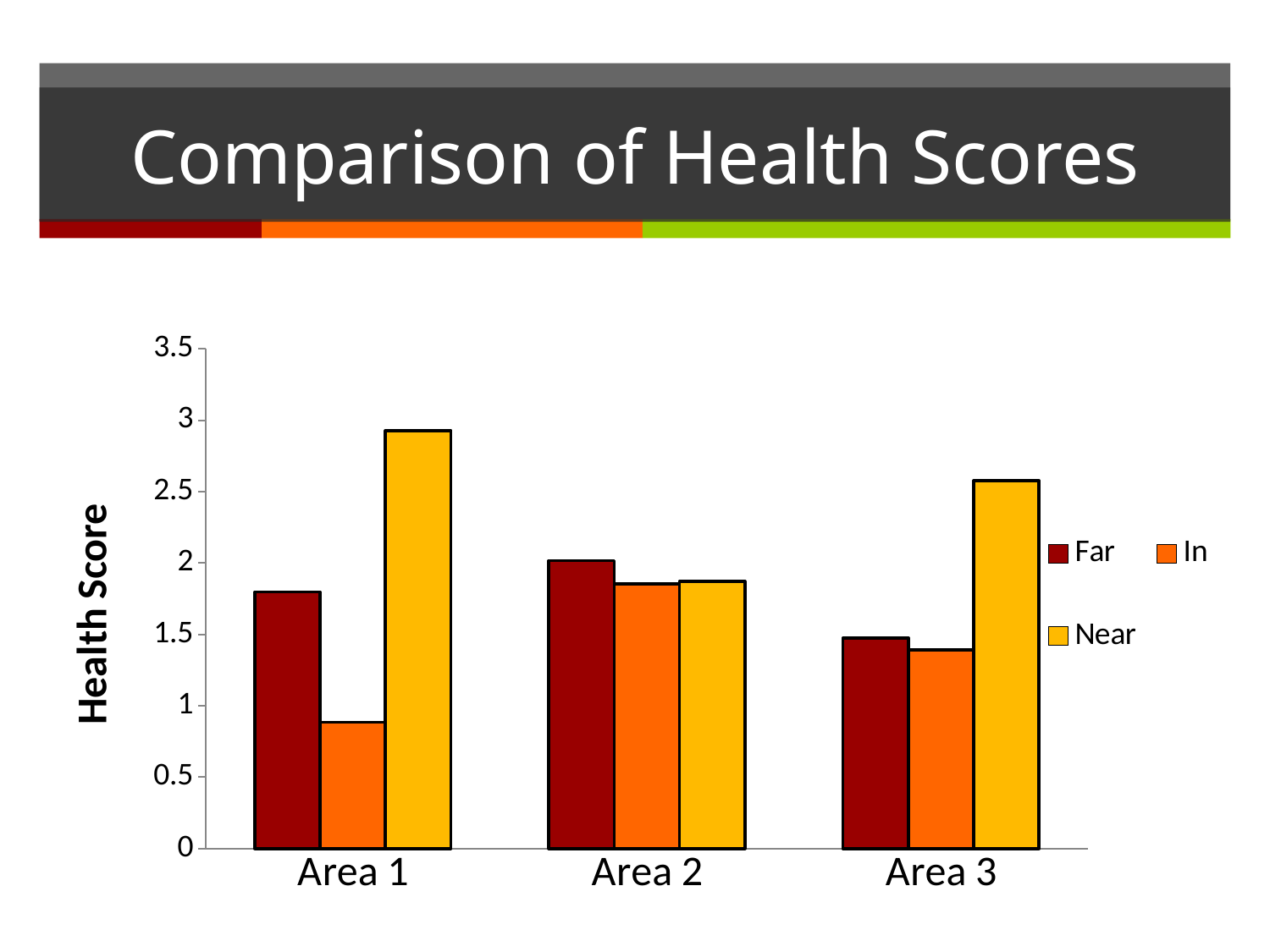
Which colour represents the Far series in the legend? dark red Which series has the lowest health score in Area 1? In Which series has the highest health score in Area 1? Near What is the label on the vertical axis? Health Score Is the Far health score for Area 3 greater or less than 2? less How many series does the legend list? 3 How many areas are shown along the x axis? 3 What kind of chart is shown on the slide? bar chart Is the Near health score for Area 1 greater or less than 2.5? greater In Area 1, which is larger, the Far score or the In score? Far Which series has the highest health score in Area 3? Near Is the In health score for Area 1 greater or less than 1? less